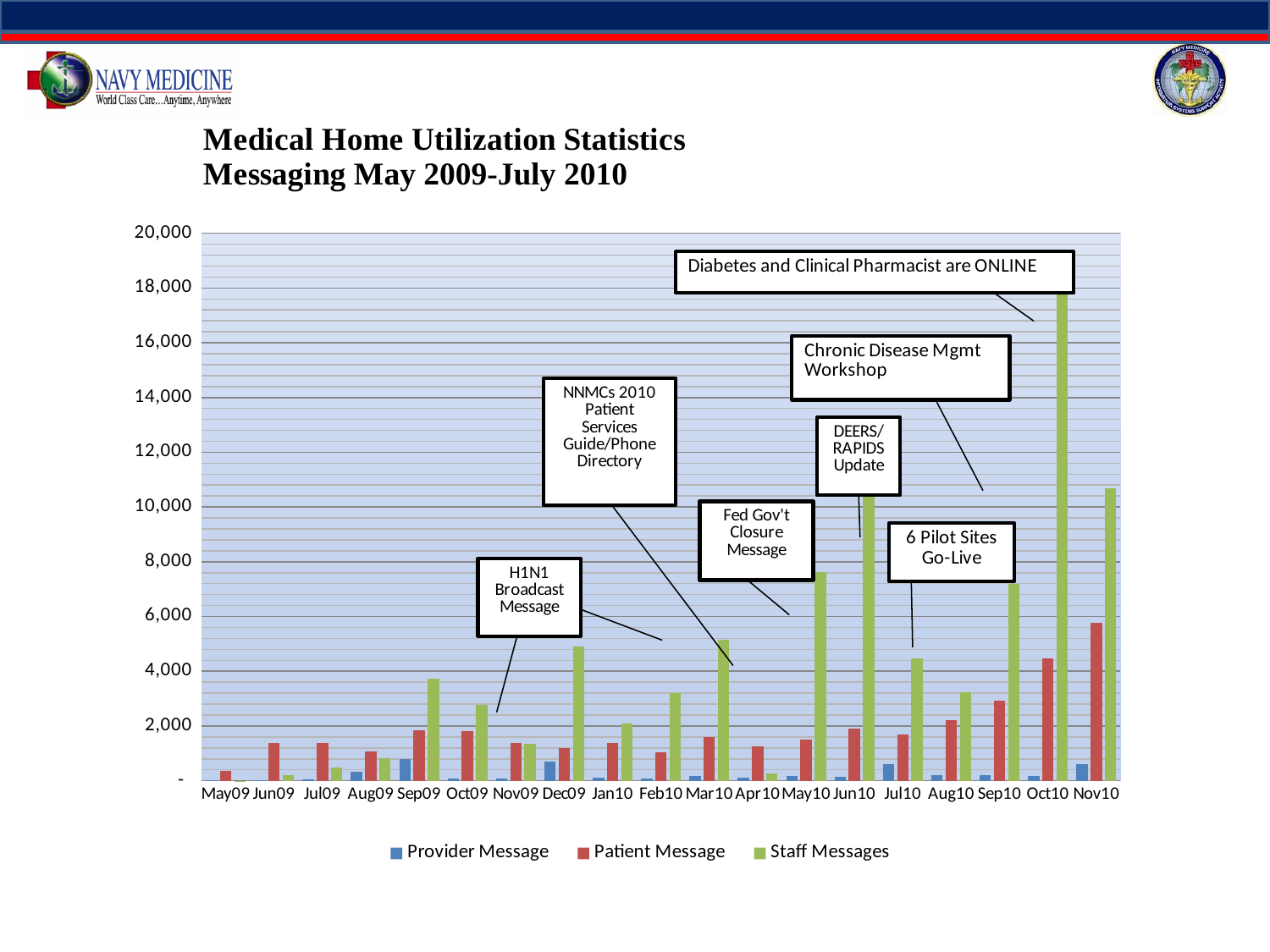
Do the Staff Messages values generally rise or fall from May09 to Oct10? rise How many months are shown along the x axis? 19 How many series does the legend list? 3 Is the Provider Message value for Nov10 greater or less than 2,000? less Is the Patient Message value for Nov10 greater or less than 4,000? greater In which month is the Staff Messages value highest? Oct10 What kind of chart is shown on the slide? bar chart Is the Staff Messages value for Jun10 greater or less than 8,000? greater In Oct10, which is larger: Staff Messages or Patient Message? Staff Messages Which colour represents Staff Messages in the legend? green In which month is the Patient Message value highest? Nov10